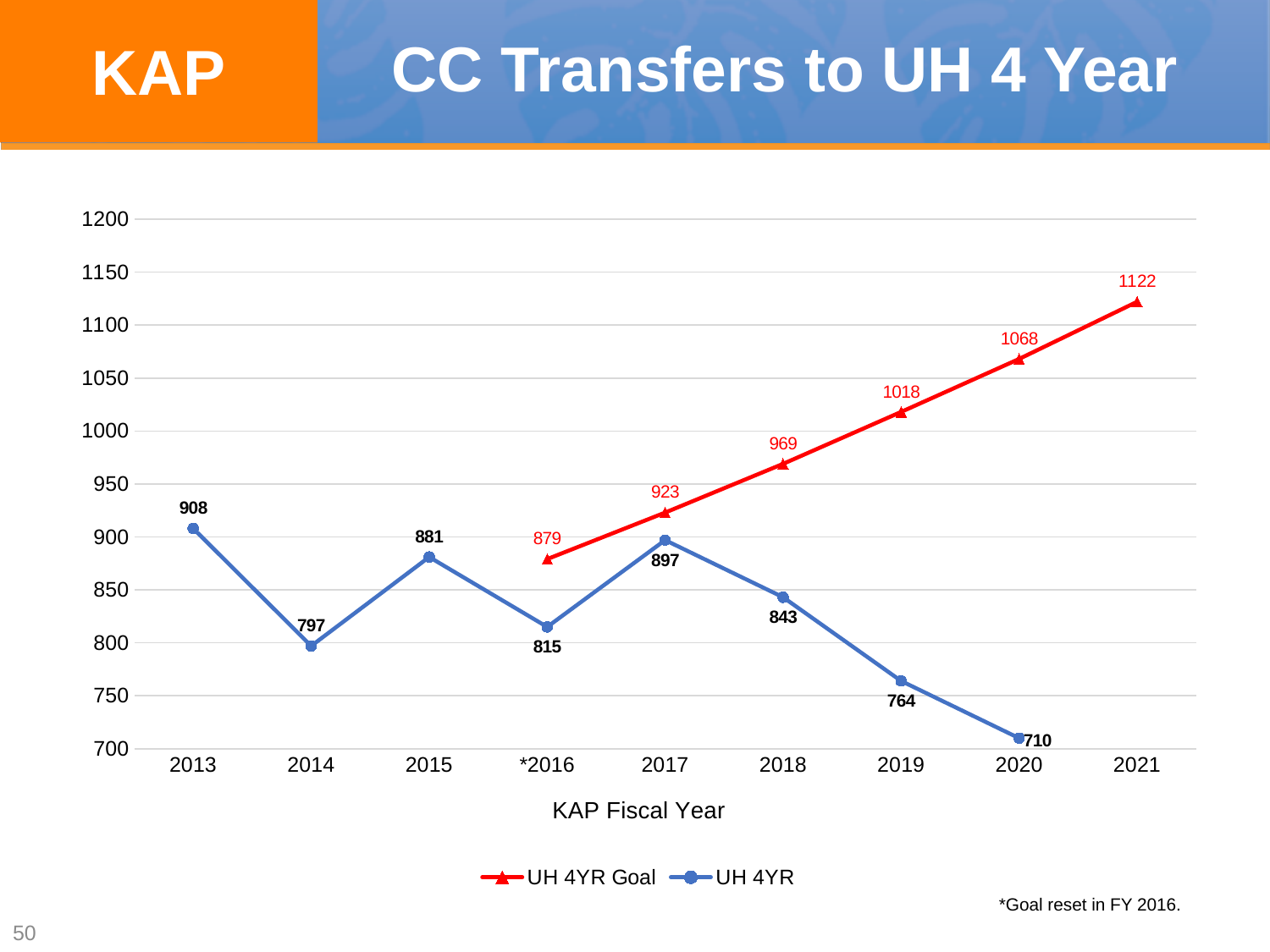
What is the label of the x axis? KAP Fiscal Year Which is larger in 2017, the UH 4YR Goal or the UH 4YR value? UH 4YR Goal What is the UH 4YR Goal value for *2016? 879 Which year has the lowest UH 4YR value? 2020 What is the difference between the UH 4YR Goal and the UH 4YR value in 2020? 358 How many series does the legend list? 2 Does the UH 4YR Goal series rise or fall from *2016 to 2021? Rise Which year has the highest UH 4YR value? 2013 What kind of chart is shown on the slide? Line chart What is the UH 4YR Goal value for 2021? 1122 What is the UH 4YR value for 2020? 710 What is the UH 4YR value for 2013? 908